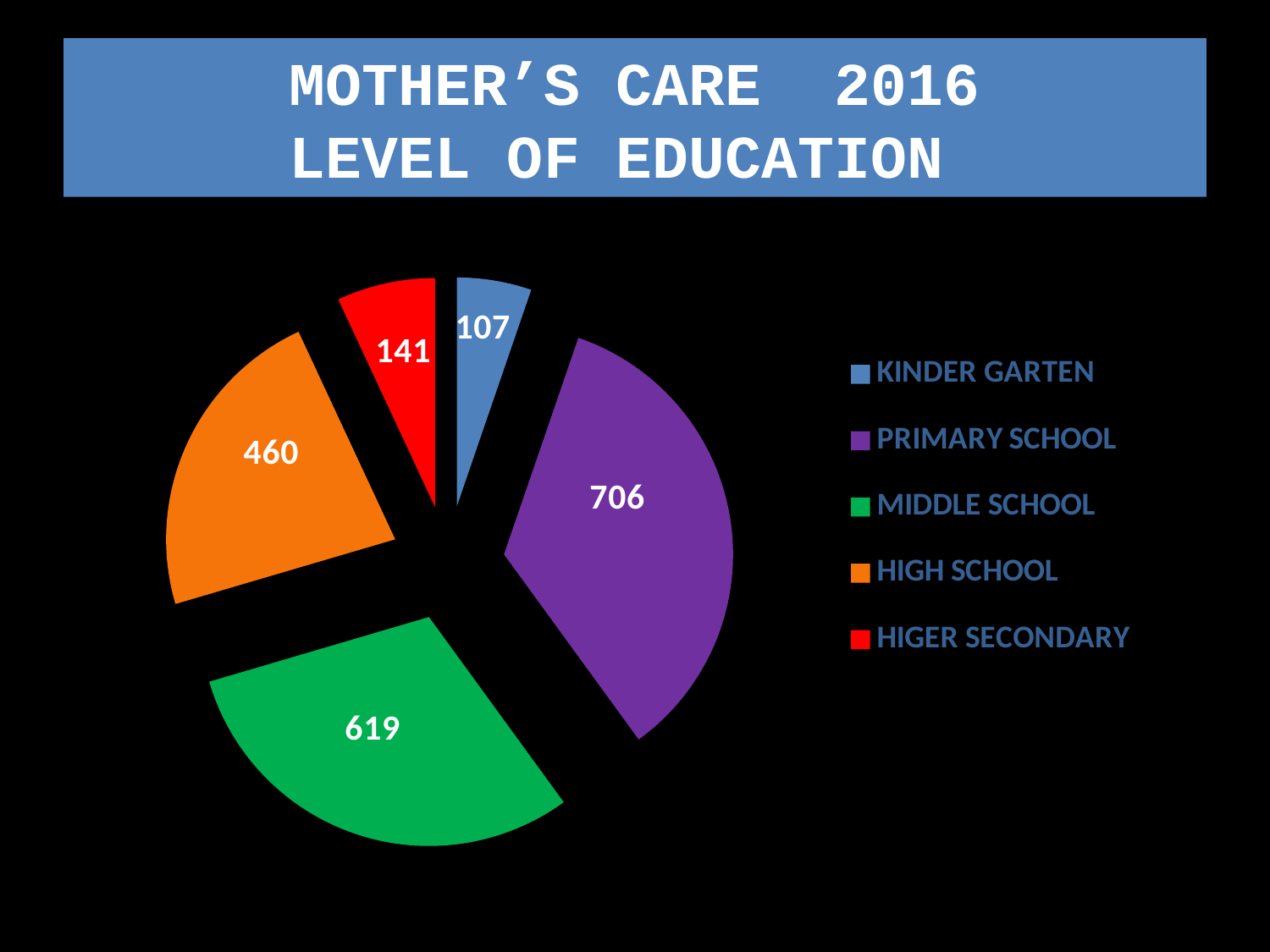
How many categories does the pie chart have? 5 What is the value for High School? 460 What is the difference between the High School and Higher Secondary values? 319 What colour is the Middle School slice? Green What kind of chart is shown on the slide? Pie chart What is the value for Primary School? 706 What is the difference between the Primary School and Middle School values? 87 Which is larger, Middle School or High School? Middle School Which level of education has the smallest slice? Kinder Garten What is the value for Kinder Garten? 107 Which level of education has the largest slice? Primary School What is the total of all the slices in the pie chart? 2033